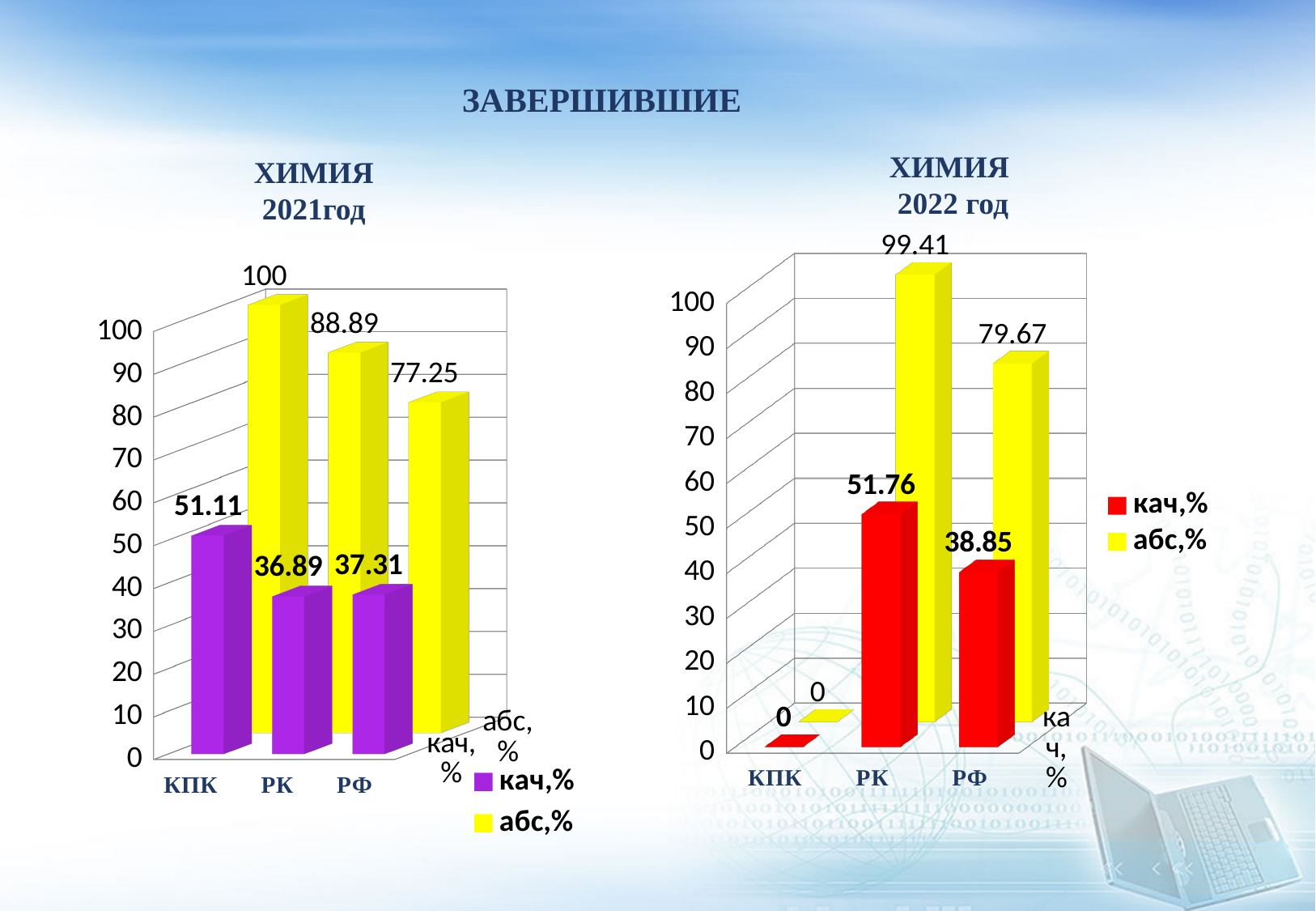
In the ХИМИЯ 2022 год chart, which is larger, the кач,% value for РК or for РФ? РК In the ХИМИЯ 2022 год chart, what is the абс,% value for РК? 99.41 In the ХИМИЯ 2022 год chart, what is the difference between the абс,% values for РК and РФ? 19.74 In the ХИМИЯ 2021год chart, what is the кач,% value for РФ? 37.31 How many series does the legend of the ХИМИЯ 2021год chart list? 2 In the ХИМИЯ 2021год chart, which category has the highest кач,% value? КПК What type of chart is the ХИМИЯ 2022 год chart? Bar chart In the ХИМИЯ 2021год chart, what is the абс,% value for КПК? 100 How many categories are shown on the x axis of the ХИМИЯ 2022 год chart? 3 In the ХИМИЯ 2021год chart, what is the difference between the абс,% values for КПК and РК? 11.11 In the ХИМИЯ 2021год chart, which category has the lowest абс,% value? РФ In the ХИМИЯ 2022 год chart, what is the кач,% value for КПК? 0